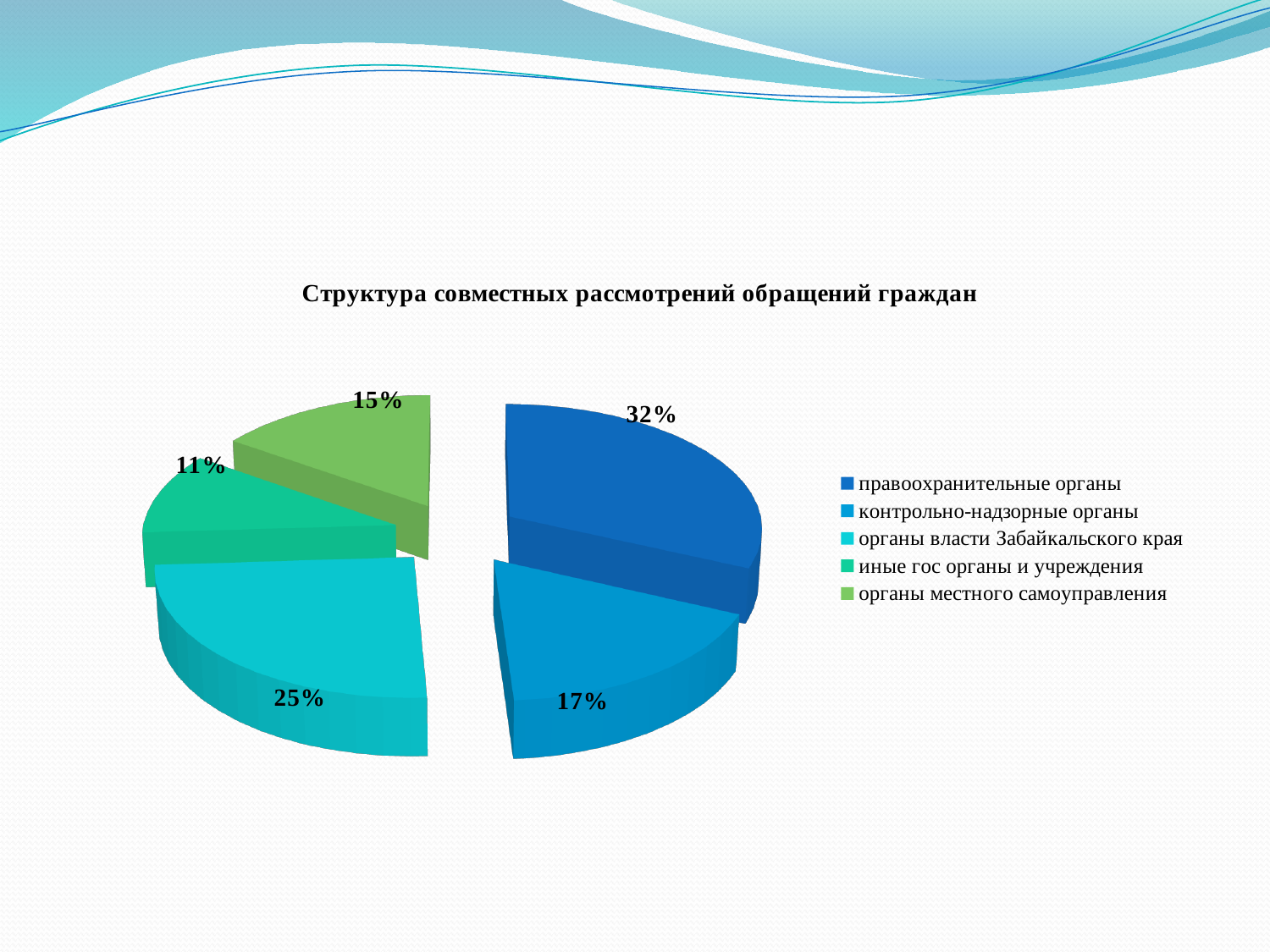
What share of the pie is labelled for иные гос органы и учреждения? 11% Which is larger: the slice for органы власти Забайкальского края or the slice for органы местного самоуправления? органы власти Забайкальского края What share of the pie is labelled for правоохранительные органы? 32% What is the title of the chart? Структура совместных рассмотрений обращений граждан What share of the pie is labelled for органы местного самоуправления? 15% What type of chart is shown on the slide? pie chart How many categories does the legend list? 5 Which category has the largest slice of the pie? правоохранительные органы What share of the pie is labelled for органы власти Забайкальского края? 25% What is the difference in percentage points between правоохранительные органы and контрольно-надзорные органы? 15 Which category has the smallest slice of the pie? иные гос органы и учреждения What share of the pie is labelled for контрольно-надзорные органы? 17%